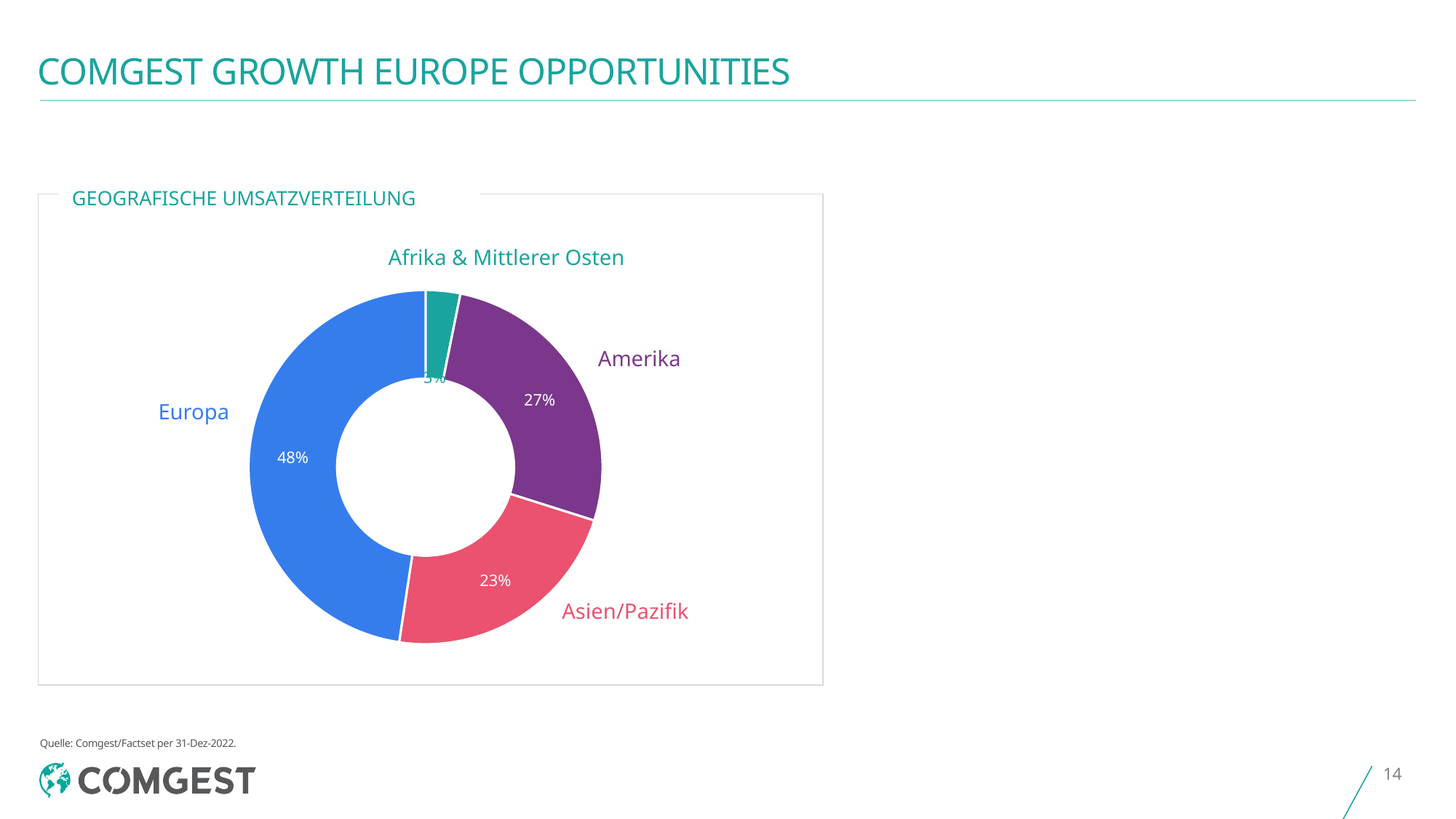
What share of revenue does Asien/Pazifik account for? 23% What share of revenue does Europa account for? 48% What share of revenue does Amerika account for? 27% Which has a larger share, Amerika or Asien/Pazifik? Amerika Which region has the smallest share of revenue? Afrika & Mittlerer Osten Which region has the largest share of revenue? Europa What is the title of the chart? Geografische Umsatzverteilung What kind of chart is shown under 'Geografische Umsatzverteilung'? Pie chart (donut) How many regions are shown in the chart? 4 What is the difference in percentage points between Amerika and Asien/Pazifik? 4 percentage points What colour is the Europa segment of the chart? Blue What is the difference in percentage points between Europa and Amerika? 21 percentage points